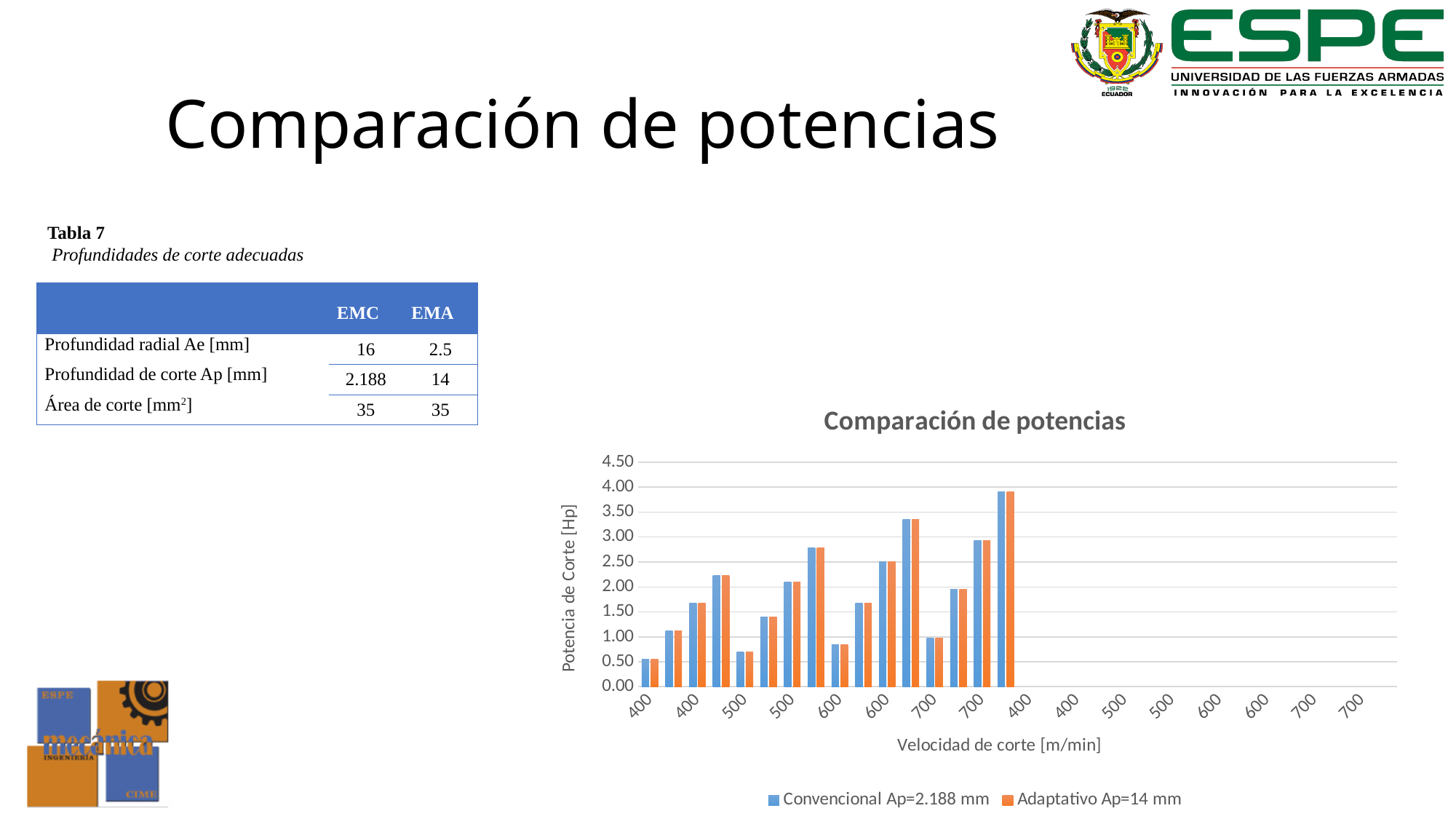
Which is larger in the chart: the first pair of bars or the last pair of bars? the last pair What are the two series named in the chart legend? Convencional Ap=2.188 mm and Adaptativo Ap=14 mm Is the value of the first (leftmost) blue bar in the chart greater or less than 1.00? less Which pair of bars in the chart has the lowest power value? the first (leftmost) pair Is the value of the tallest blue bar in the chart greater or less than 3.50? greater How many series does the legend of the chart list? 2 Which pair of bars in the chart reaches the highest power value? the last (rightmost) pair What is the highest tick value shown on the vertical axis of the chart? 4.50 What kind of chart is shown on the slide? bar chart How many category labels are shown along the x axis of the chart? 16 What is the title of the vertical axis of the chart? Potencia de Corte [Hp] Is the value of the fourth pair of bars from the left greater or less than 2.00? greater